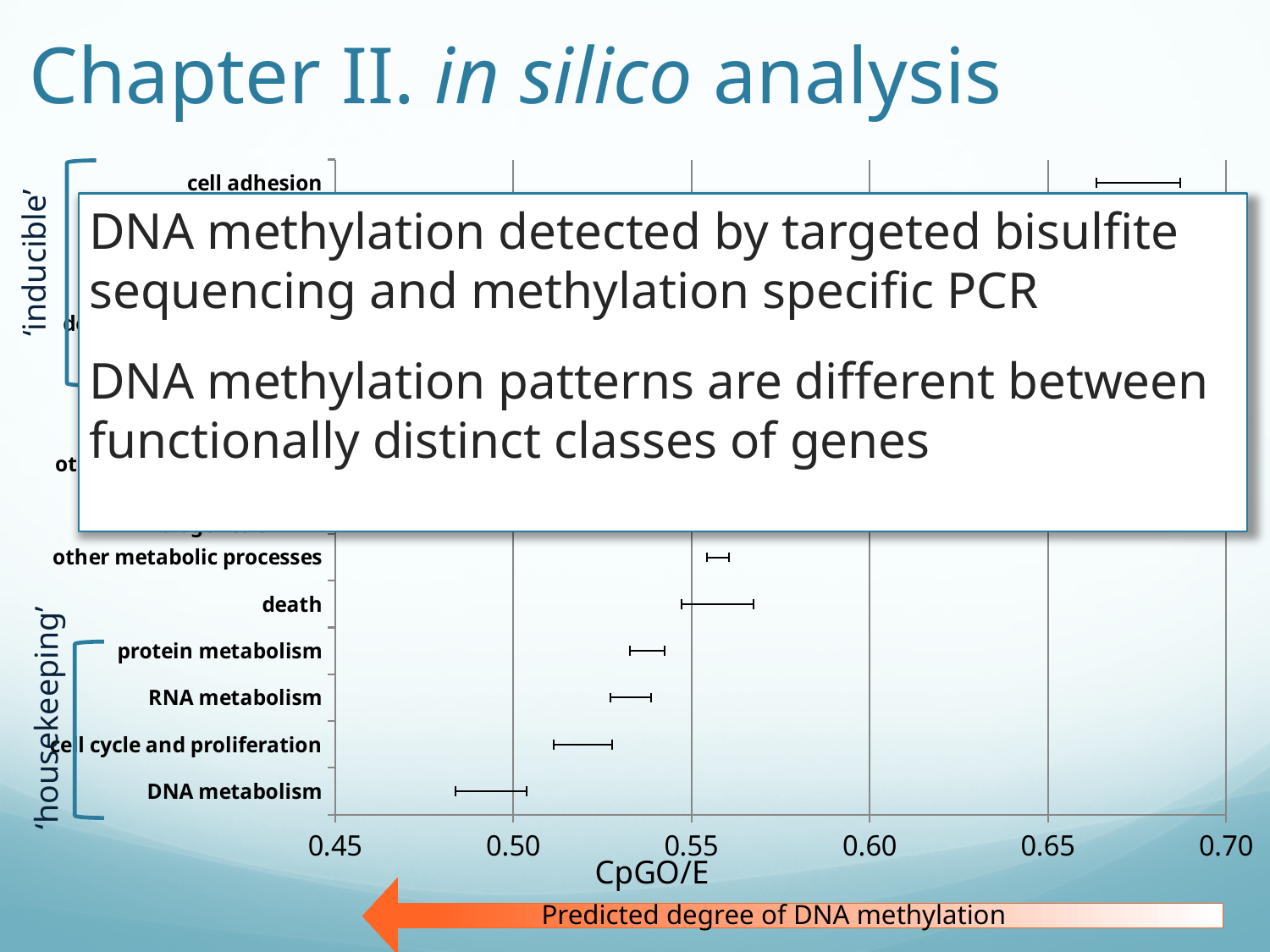
Is the CpGO/E value for protein metabolism greater or less than 0.50? greater What is the label of the horizontal axis of the chart? CpGO/E Is the CpGO/E value for RNA metabolism greater or less than 0.55? less Which has a higher CpGO/E value, death or cell cycle and proliferation? death Is the CpGO/E value for cell adhesion greater or less than 0.65? greater Which readable category has the lowest CpGO/E value? DNA metabolism What are the two gene groups labelled along the left side of the chart? 'inducible' and 'housekeeping' Which readable category has the highest CpGO/E value? cell adhesion Which has a higher CpGO/E value, cell adhesion or DNA metabolism? cell adhesion